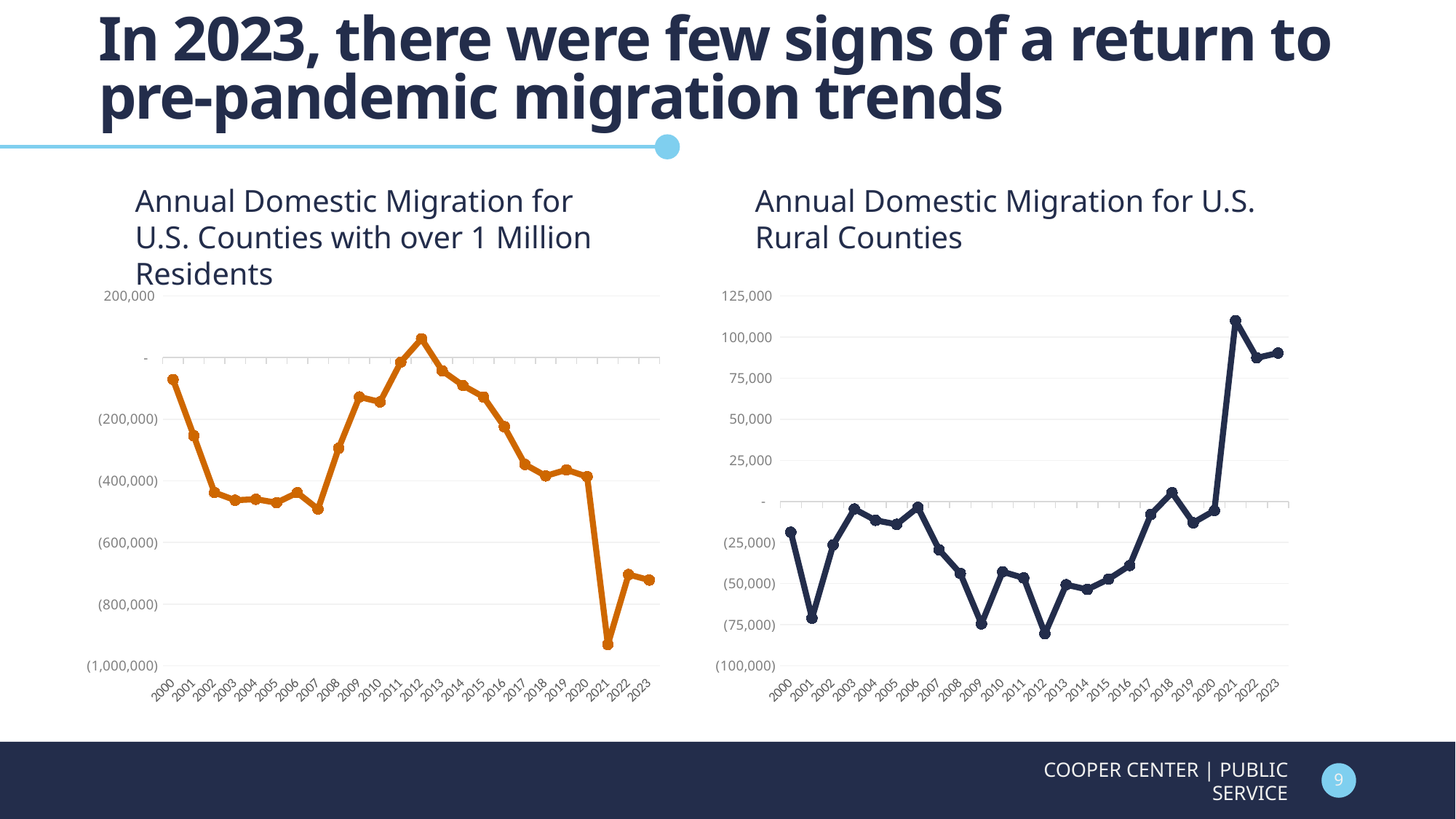
What colour is the line on the 'Annual Domestic Migration for U.S. Counties with over 1 Million Residents' chart? Orange On the 'Annual Domestic Migration for U.S. Rural Counties' chart, is the value for 2021 greater or less than 100,000? greater On the 'Annual Domestic Migration for U.S. Rural Counties' chart, is the value for 2000 greater or less than 0? less On the 'Annual Domestic Migration for U.S. Counties with over 1 Million Residents' chart, which year has the lowest value? 2021 On the 'Annual Domestic Migration for U.S. Counties with over 1 Million Residents' chart, is the value for 2021 greater or less than (800,000)? less On the 'Annual Domestic Migration for U.S. Rural Counties' chart, which year has the highest value? 2021 On the 'Annual Domestic Migration for U.S. Counties with over 1 Million Residents' chart, which year has the higher value, 2002 or 2009? 2009 On the 'Annual Domestic Migration for U.S. Counties with over 1 Million Residents' chart, which year has the highest value? 2012 On the 'Annual Domestic Migration for U.S. Counties with over 1 Million Residents' chart, do values rise or fall from 2012 to 2021? Fall What kind of chart is the 'Annual Domestic Migration for U.S. Counties with over 1 Million Residents' chart? Line chart How many years are plotted on the 'Annual Domestic Migration for U.S. Rural Counties' chart? 24